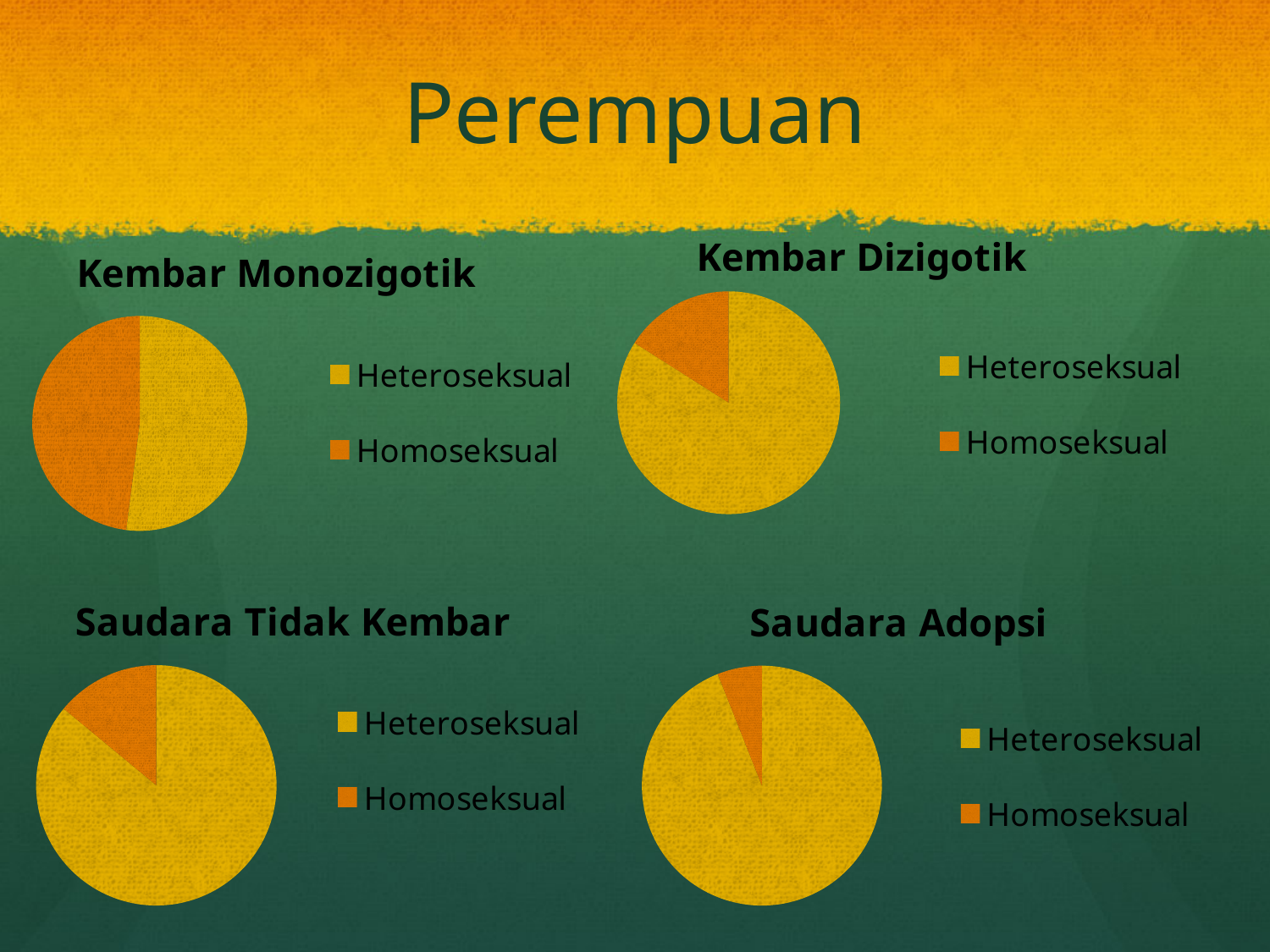
In the "Saudara Tidak Kembar" chart, which category has the largest slice? Heteroseksual In the "Kembar Monozigotik" chart, which legend entry is shown in orange? Homoseksual In the "Saudara Adopsi" chart, which category has the smallest slice? Homoseksual In the "Saudara Tidak Kembar" chart, which slice is smaller, Heteroseksual or Homoseksual? Homoseksual In the "Saudara Adopsi" chart, which slice is larger, Heteroseksual or Homoseksual? Heteroseksual What is the title of the chart in the top-right of the slide? Kembar Dizigotik How many pie charts are shown on the slide? 4 How many slices does the "Saudara Adopsi" pie chart have? 2 In the "Kembar Dizigotik" chart, which category has the smallest slice? Homoseksual In the "Kembar Dizigotik" chart, which category has the largest slice? Heteroseksual What kind of chart is the "Kembar Monozigotik" chart? pie chart How many categories does the legend of the "Kembar Monozigotik" chart list? 2